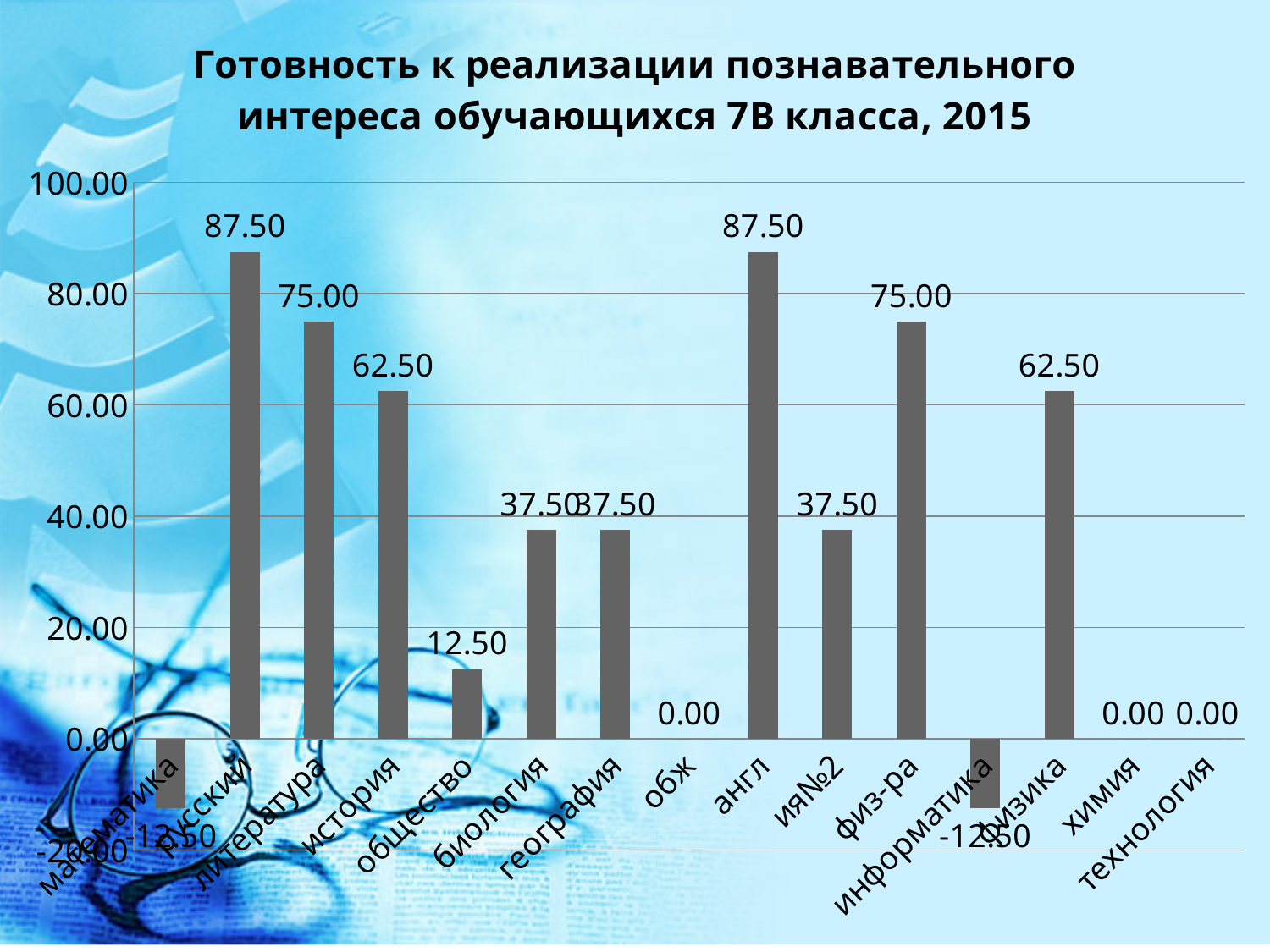
What is the value for общество? 12.50 What kind of chart is shown on the slide? bar chart How many categories are shown on the x axis? 15 What is the value for информатика? -12.50 What year is mentioned in the chart title? 2015 What is the value for русский? 87.50 What is the value for история? 62.50 What is the value for физ-ра? 75.00 Which is larger, the value for физика or the value for ия№2? физика What is the difference between the values for литература and биология? 37.50 Which categories have a value of 0.00? обж, химия, технология Is the value for математика greater or less than 0.00? less